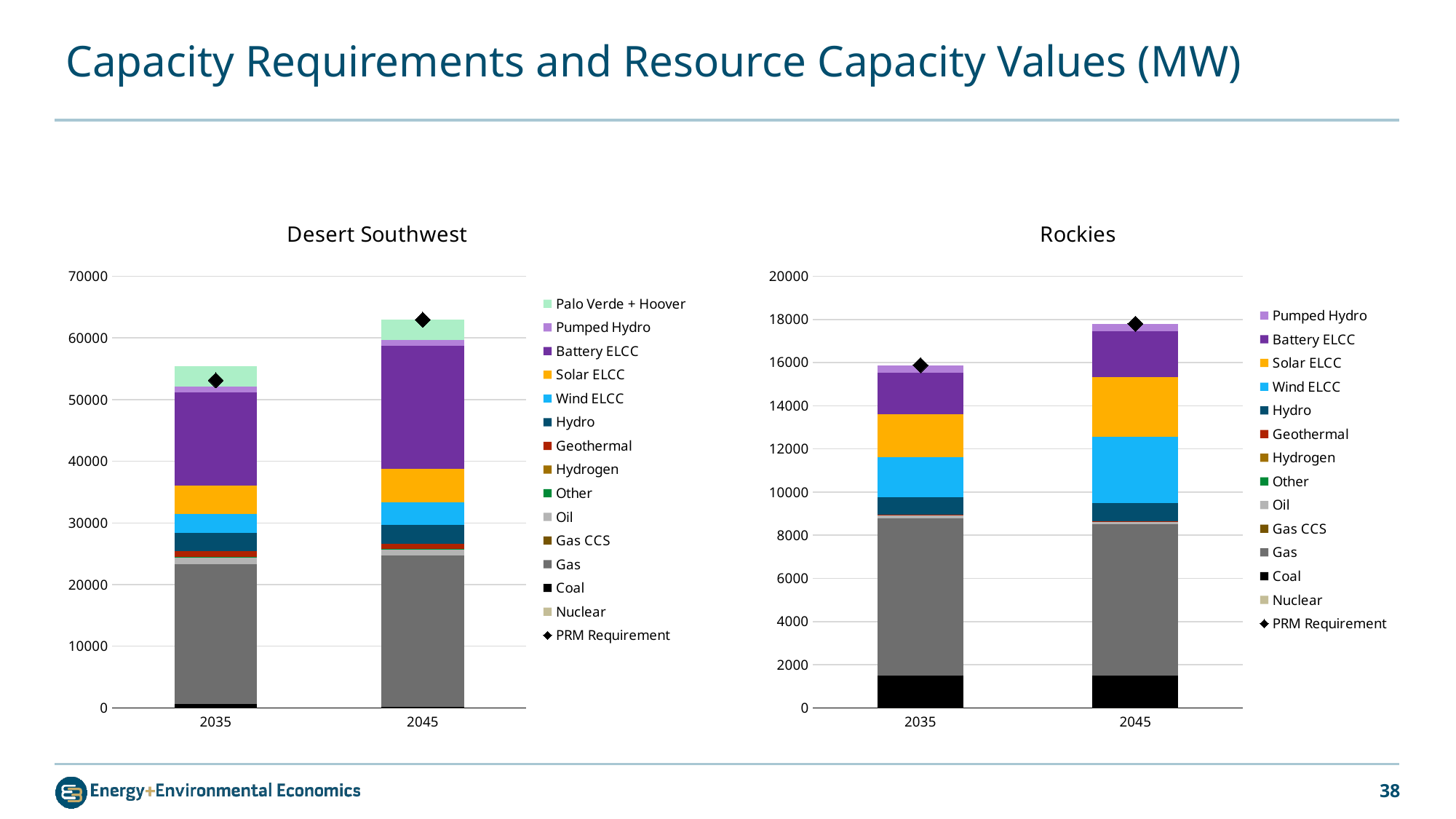
In the Rockies chart, does the total capacity rise or fall from 2035 to 2045? Rise In the Desert Southwest chart, is the total stacked bar for 2035 greater or less than 60000? less In the Rockies chart, is the total stacked bar for 2045 greater or less than 16000? greater Which legend entry appears in the Desert Southwest chart but not in the Rockies chart? Palo Verde + Hoover In the Desert Southwest chart, which year has the taller total stacked bar, 2035 or 2045? 2045 In the Rockies chart, which series is shown as a black diamond marker? PRM Requirement How many categories are shown on the x axis of the Rockies chart? 2 In the Rockies chart, is the total stacked bar for 2035 greater or less than 14000? greater How many entries does the legend of the Rockies chart list? 14 How many entries does the legend of the Desert Southwest chart list? 15 What kind of chart is the Desert Southwest chart? Stacked bar chart